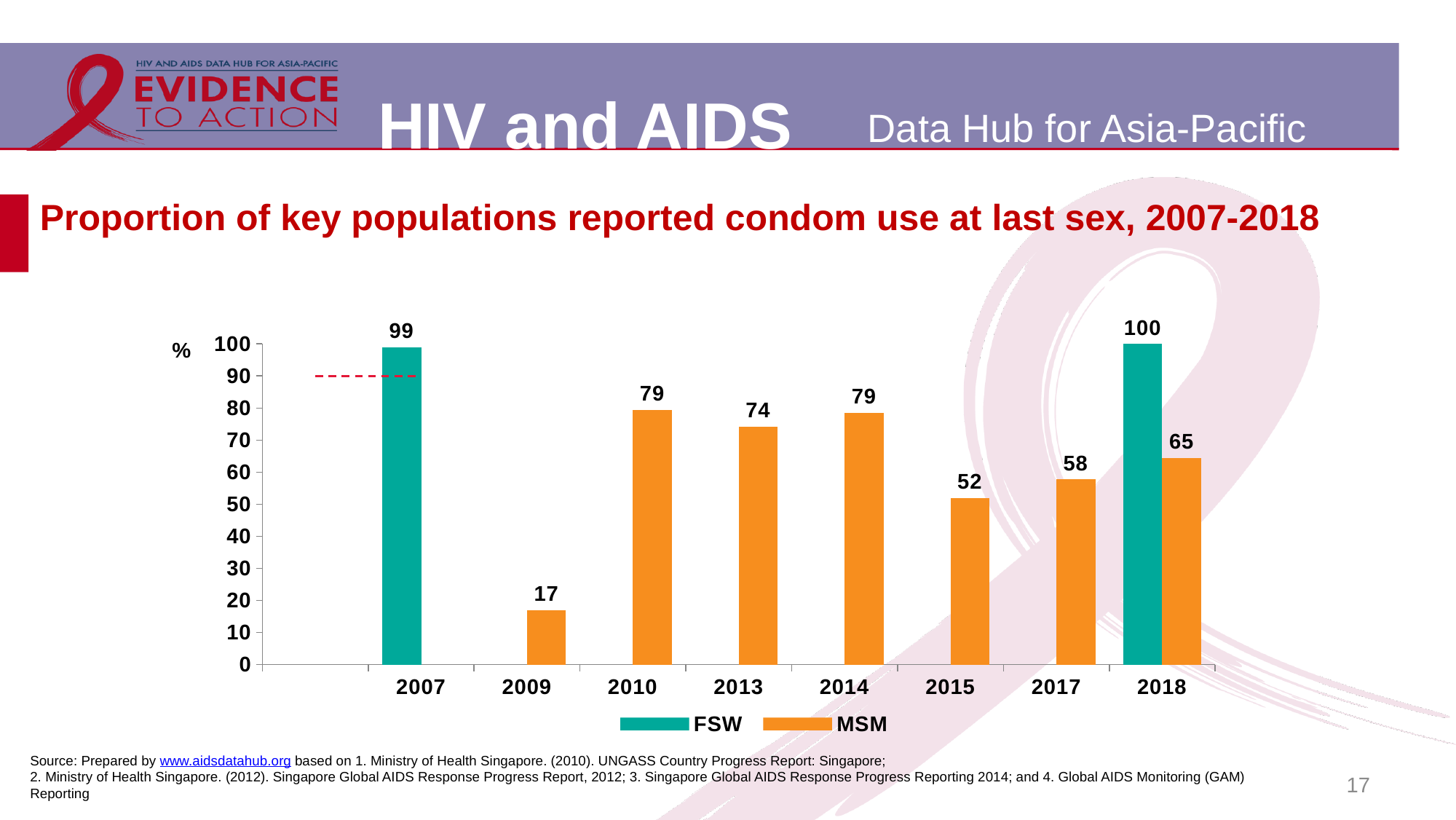
What is the MSM value for 2015? 52 What is the MSM value for 2009? 17 Which is larger, the MSM value for 2013 or the MSM value for 2017? 2013 How many series does the legend list? 2 Which series is shown in orange in the legend? MSM What type of chart is shown on the slide? bar chart How many years are shown on the x axis? 8 Do the MSM values rise or fall from 2015 to 2018? rise In which year is the MSM value lowest? 2009 What is the FSW value for 2007? 99 What is the difference between the FSW and MSM values in 2018? 35 What is the FSW value for 2018? 100